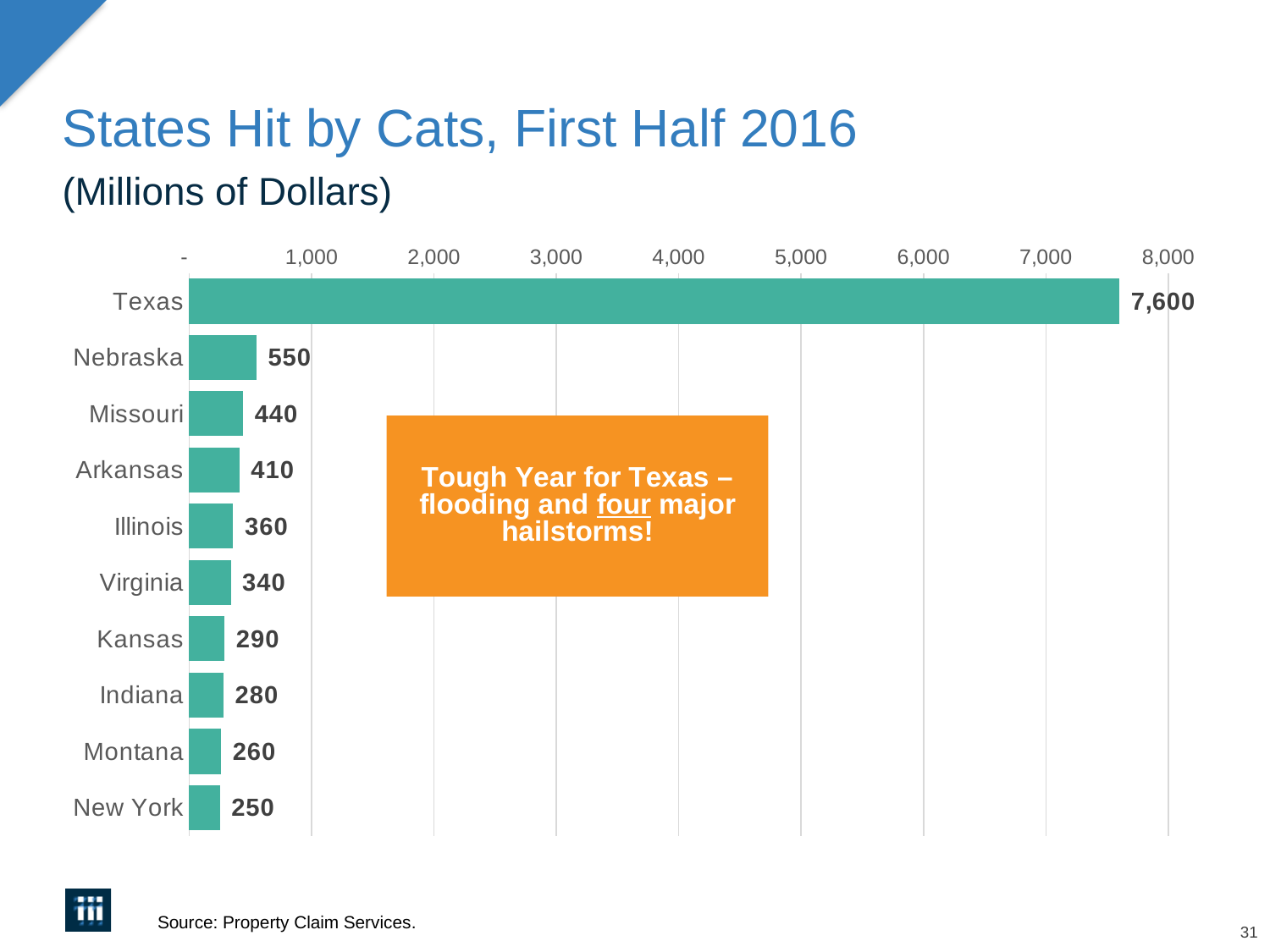
Which state has the lowest value? New York What is the value for Texas? 7,600 What is the title of the chart? States Hit by Cats, First Half 2016 What is the value for Missouri? 440 What kind of chart is shown on the slide? bar chart How many states are shown in the chart? 10 Is the value for Texas greater or less than 7,000? greater What is the difference between the values for Texas and Nebraska? 7,050 What is the value for New York? 250 Which state has the highest value? Texas What is the difference between the values for Nebraska and Arkansas? 140 Which is larger, the value for Illinois or the value for Kansas? Illinois